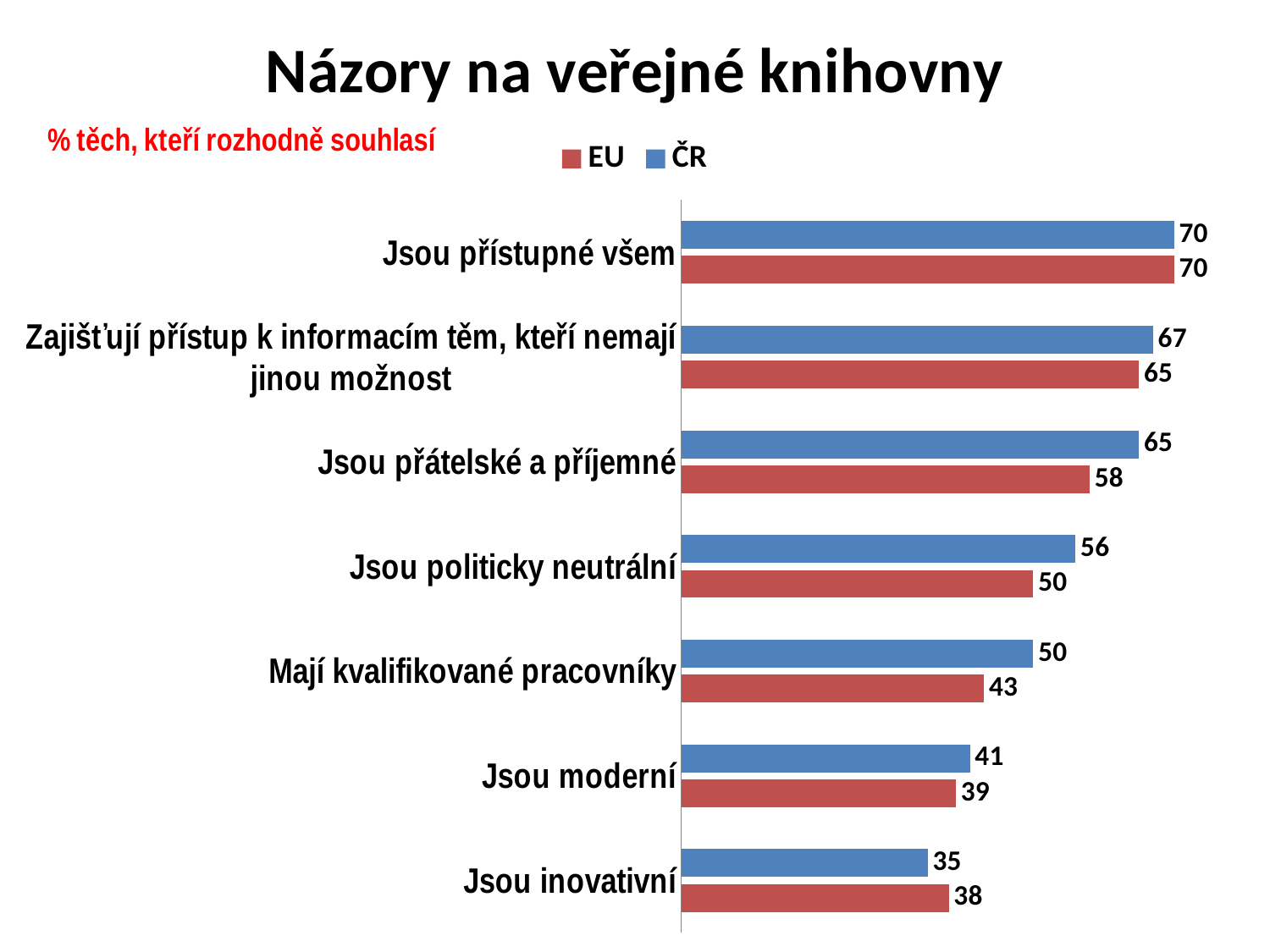
How many series does the legend list? 2 What is the ČR value for "Jsou politicky neutrální"? 56 Which category has the highest EU value? Jsou přístupné všem What is the EU value for "Mají kvalifikované pracovníky"? 43 For "Mají kvalifikované pracovníky", which is larger, the EU value or the ČR value? ČR What is the difference between the ČR and EU values for "Jsou přátelské a příjemné"? 7 How many categories are shown in the chart? 7 What is the difference between the ČR and EU values for "Jsou politicky neutrální"? 6 For "Jsou inovativní", which is larger, the EU value or the ČR value? EU Which category has the lowest ČR value? Jsou inovativní What is the EU value for "Jsou inovativní"? 38 What type of chart is shown on the slide? Bar chart